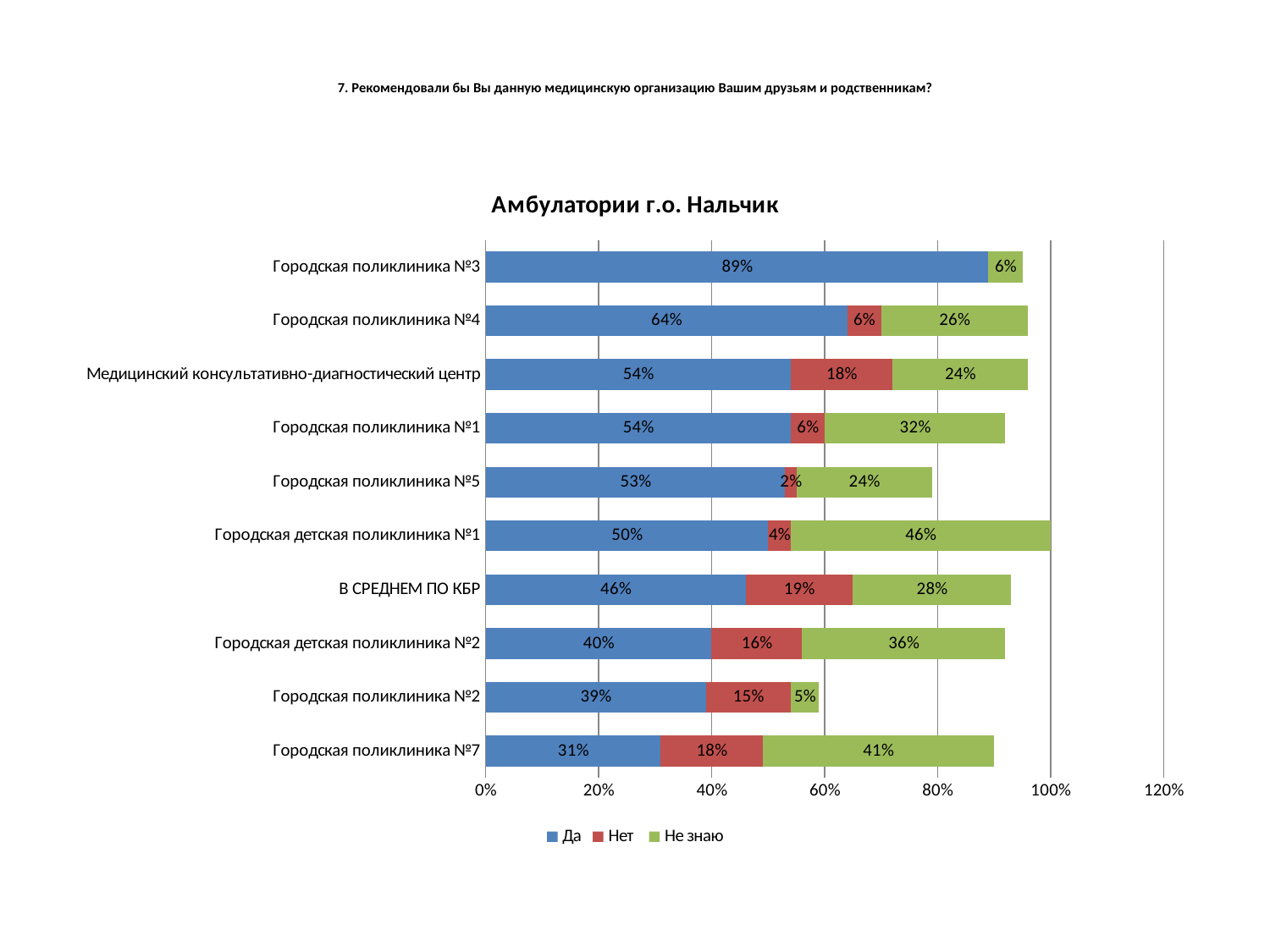
What is the "Да" value for Городская поликлиника №4? 64% Which category has the lowest "Да" value? Городская поликлиника №7 What is the total of the stacked bar for Городская поликлиника №7? 90% What kind of chart is shown on the slide? Stacked bar chart Which category has the highest "Да" value? Городская поликлиника №3 Which is larger: the "Не знаю" value for Городская поликлиника №1 or for Городская поликлиника №5? Городская поликлиника №1 What is the "Не знаю" value for Городская детская поликлиника №1? 46% How many series does the legend list? 3 What is the difference between the "Да" values for Городская поликлиника №3 and Городская поликлиника №7? 58% Is the total length of the stacked bar for Городская поликлиника №2 greater or less than 80%? less How many categories are shown on the chart? 10 What is the "Нет" value for В СРЕДНЕМ ПО КБР? 19%